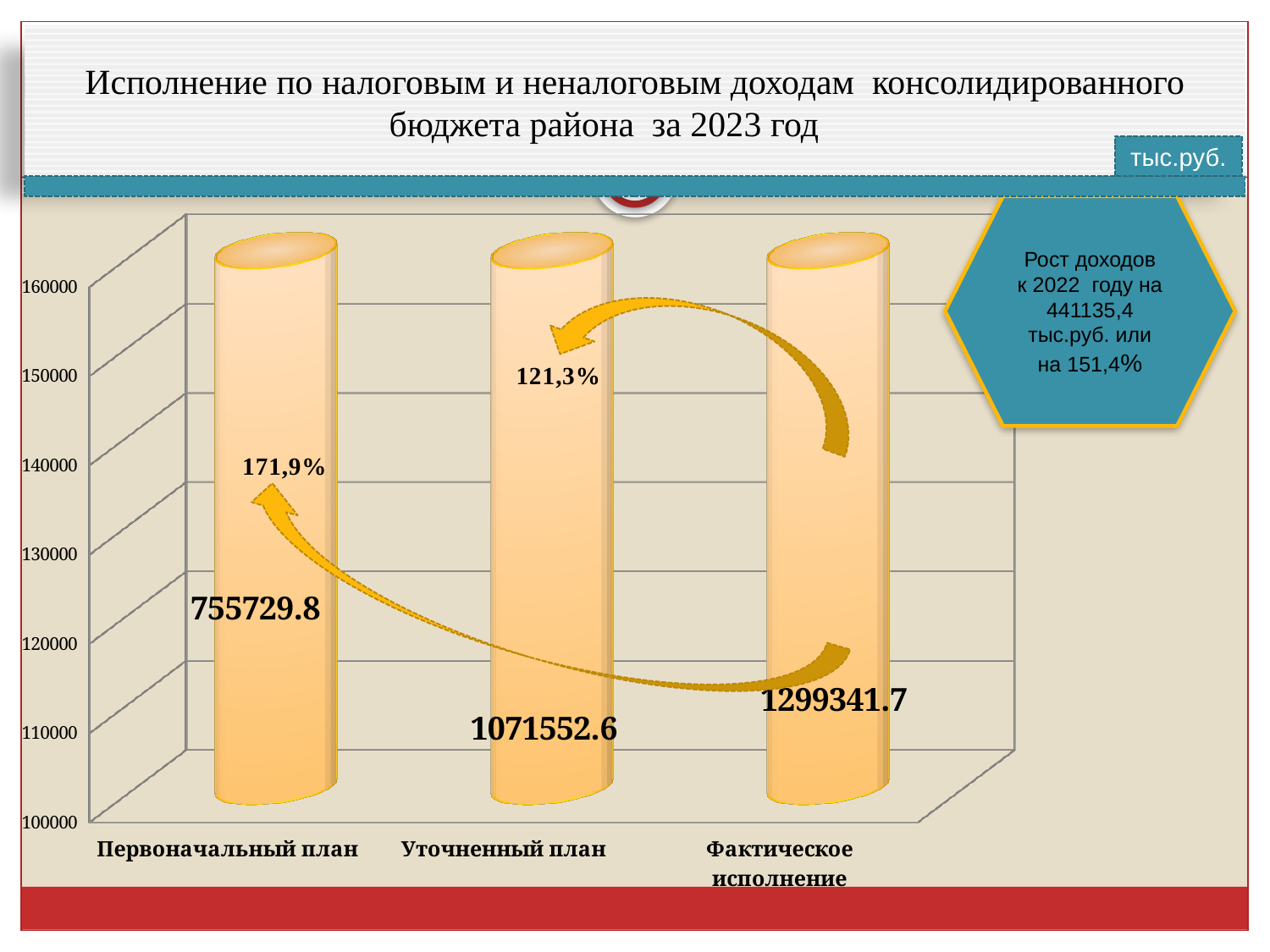
How many categories are shown on the chart? 3 Which is larger, Уточненный план or Первоначальный план? Уточненный план Which category has the highest value? Фактическое исполнение What is the value for Первоначальный план? 755729.8 What kind of chart is shown on the slide? bar chart What is the difference between Уточненный план and Первоначальный план? 315822.8 Which category has the lowest value? Первоначальный план What unit is indicated in the box at the top right of the chart? тыс.руб. What is the difference between Фактическое исполнение and Уточненный план? 227789.1 Do the values rise or fall from Первоначальный план to Фактическое исполнение? rise What is the value for Фактическое исполнение? 1299341.7 What is the value for Уточненный план? 1071552.6